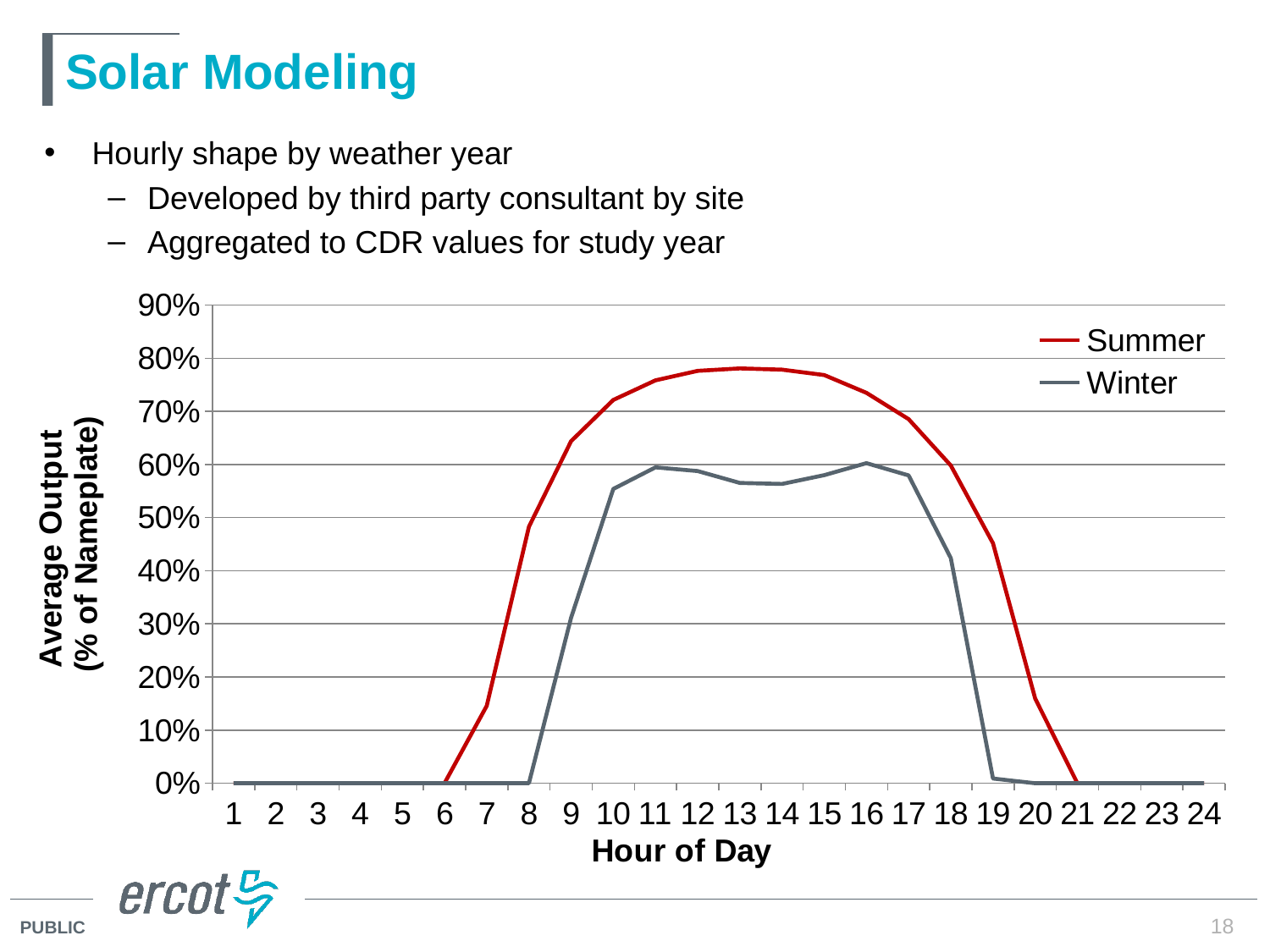
Is the Winter value at hour 9 greater or less than 40%? less How many series does the legend list? 2 Which series reaches the higher peak average output? Summer At hour 12, which series has the higher average output, Summer or Winter? Summer What is the Winter average output at hour 23? 0% Is the Winter value at hour 13 greater or less than 60%? less What kind of chart is shown on the slide? line chart Does the Summer average output rise or fall from hour 17 to hour 21? fall Is the Summer value at hour 13 greater or less than 70%? greater What is the Summer average output at hour 3? 0% How many hours of the day are plotted along the x axis? 24